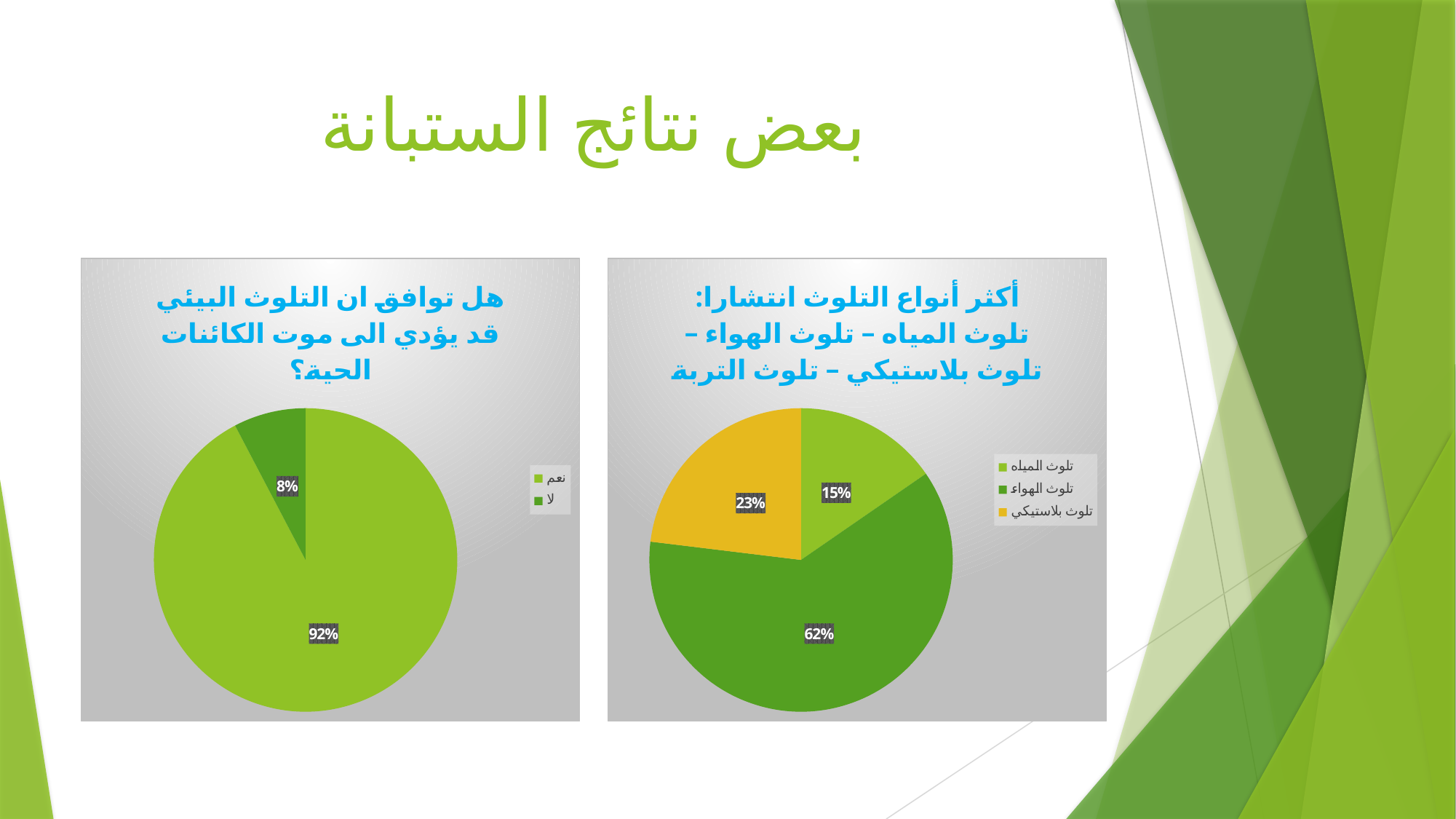
In the right chart, which pollution type has the smallest slice? تلوث المياه In the right chart, what share is shown for تلوث بلاستيكي? 23% In the left chart, what is the difference between the نعم and لا shares? 84% In the right chart (أكثر أنواع التلوث انتشارا), what share is shown for تلوث الهواء? 62% In the left chart, what share of respondents answered نعم? 92% In the left chart, which answer has the larger slice, نعم or لا? نعم In the right chart, what is the difference between the shares of تلوث بلاستيكي and تلوث المياه? 8% In the right chart, which pollution type has the largest slice? تلوث الهواء What kind of chart is the left chart (هل توافق ان التلوث البيئي قد يؤدي الى موت الكائنات الحية؟)? Pie chart How many entries does the legend of the left chart list? 2